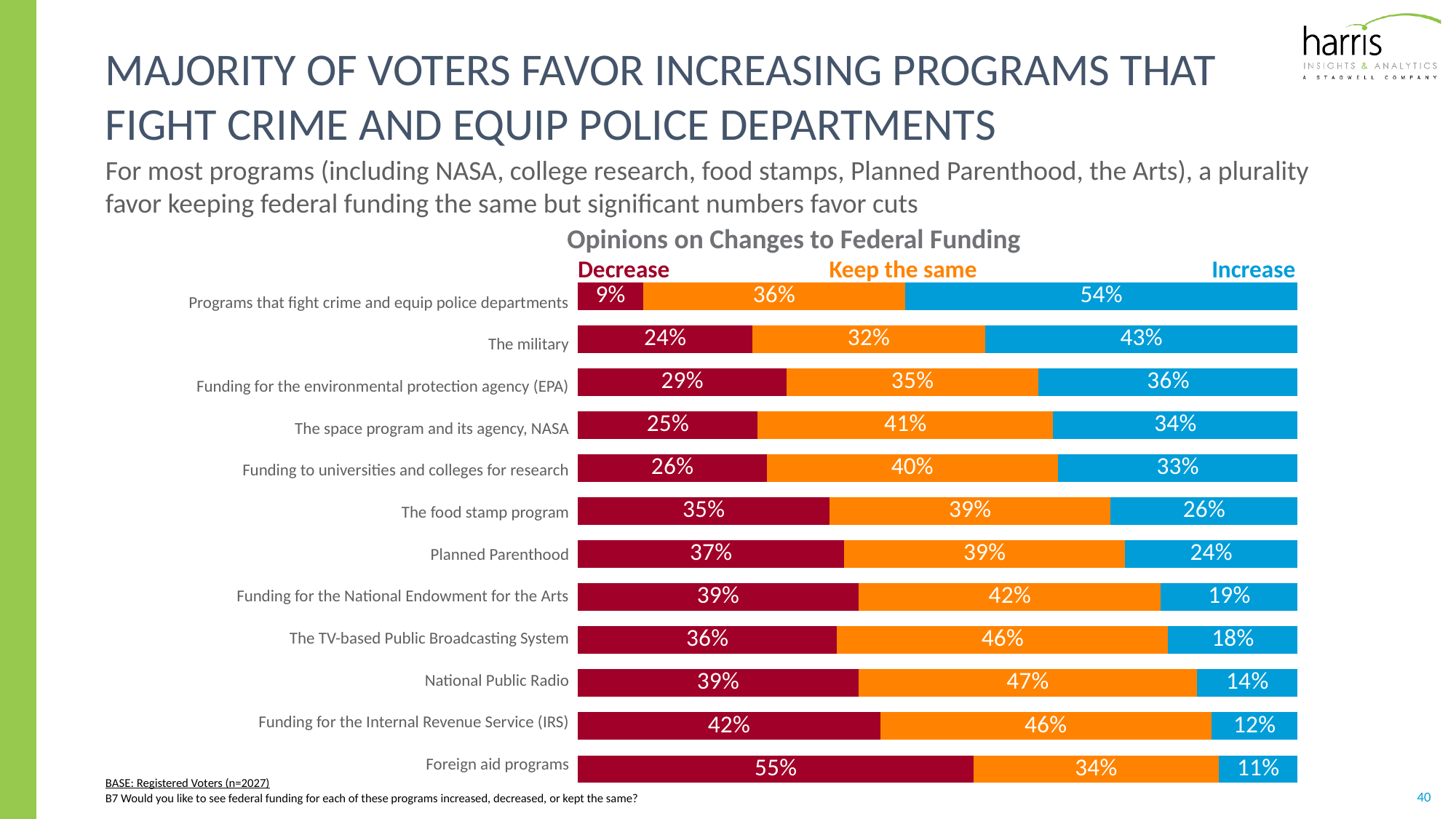
For the military, how many percentage points higher is the 'Increase' value than the 'Decrease' value? 19 What is the 'Keep the same' value for National Public Radio? 47% What is the title of the chart? Opinions on Changes to Federal Funding What percentage of voters favor decreasing funding for foreign aid programs? 55% Which program has the lowest 'Decrease' percentage? Programs that fight crime and equip police departments What type of chart is shown on the slide? Stacked bar chart Which program has the highest 'Increase' percentage? Programs that fight crime and equip police departments What percentage of voters favor increasing funding for programs that fight crime and equip police departments? 54% Which program has the lowest 'Increase' percentage? Foreign aid programs How many series (response options) does the chart show? 3 Which has a larger 'Keep the same' value: the space program (NASA) or the environmental protection agency (EPA)? The space program and its agency, NASA How many programs are listed in the chart? 12